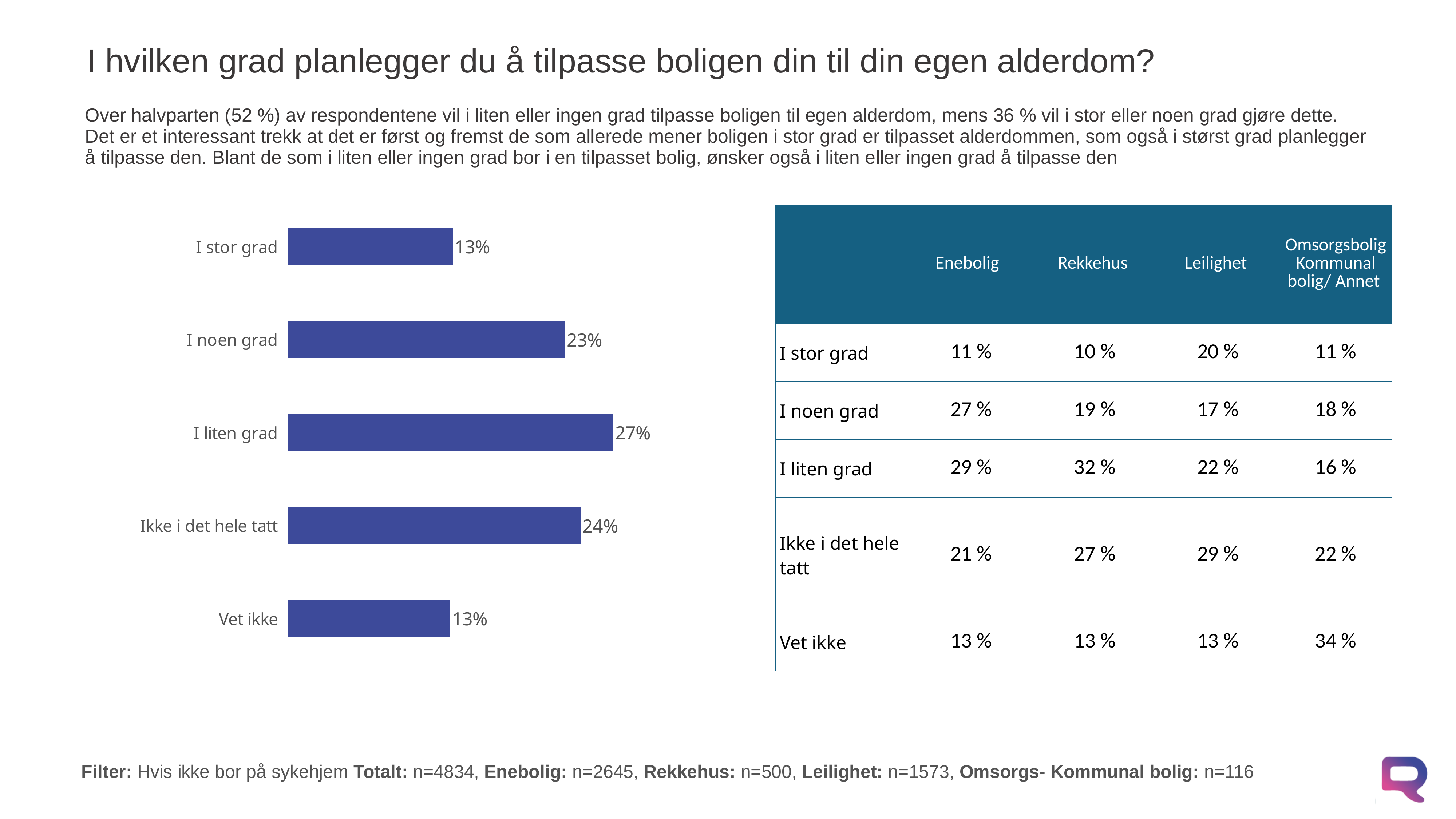
Which is larger in the bar chart, the value for "I liten grad" or the value for "Vet ikke"? I liten grad Which is larger in the bar chart, the value for "Ikke i det hele tatt" or the value for "I noen grad"? Ikke i det hele tatt How many categories are shown in the bar chart? 5 What is the value for "Vet ikke" in the bar chart? 13% What is the value for "I liten grad" in the bar chart? 27% What is the difference between the values for "I liten grad" and "I noen grad" in the bar chart? 4 percentage points What is the value for "I stor grad" in the bar chart? 13% What is the value for "Ikke i det hele tatt" in the bar chart? 24% What is the value for "I noen grad" in the bar chart? 23% What kind of chart is shown on the left of the slide? Bar chart Which category has the highest value in the bar chart? I liten grad What is the difference between the values for "Ikke i det hele tatt" and "I stor grad" in the bar chart? 11 percentage points